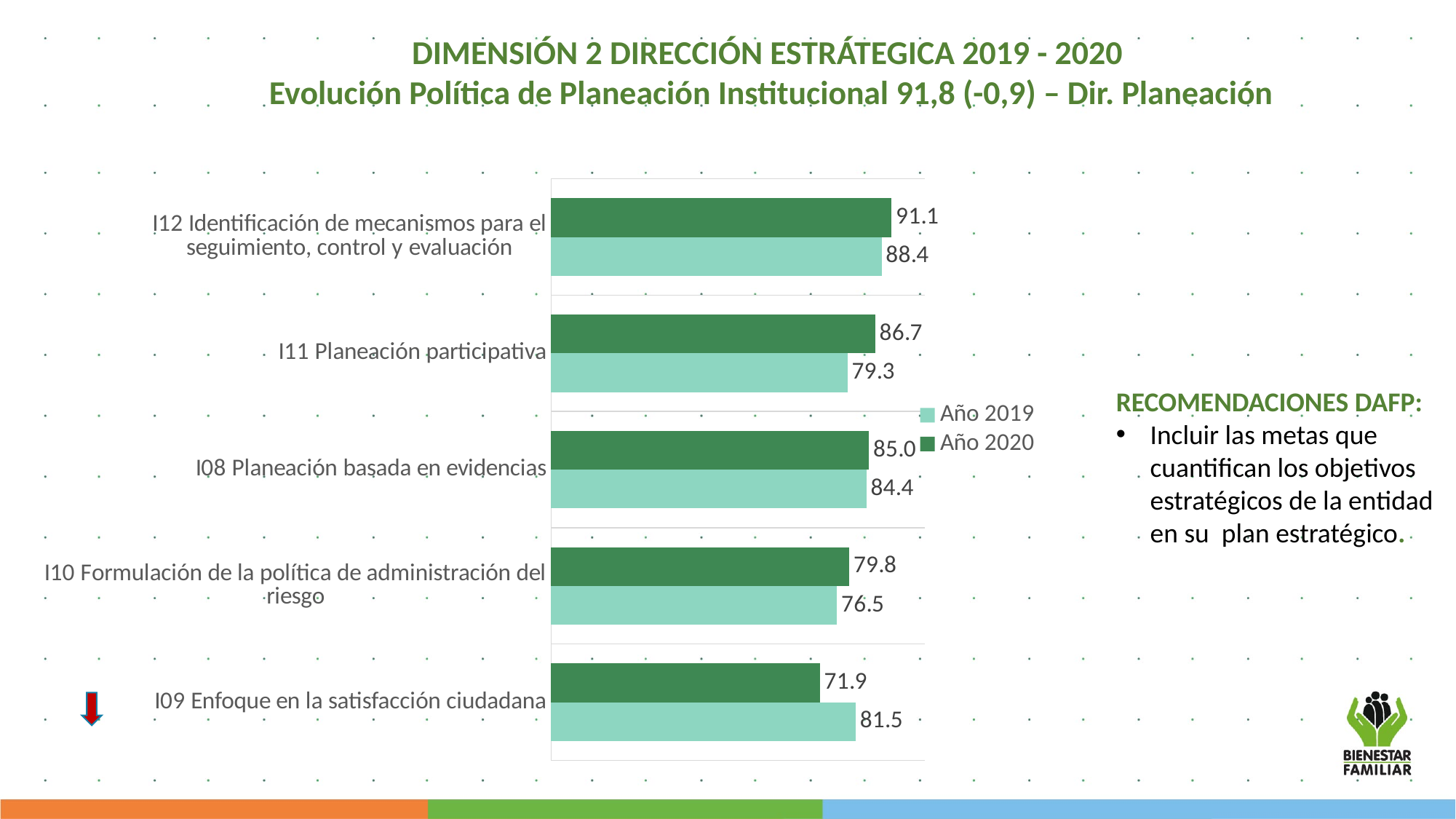
What kind of chart is shown on the slide? Bar chart How many series does the legend list? 2 What is the difference between the Año 2020 and Año 2019 values for I11 Planeación participativa? 7.4 Which category has the lowest Año 2019 value? I10 Formulación de la política de administración del riesgo What is the Año 2020 value for I12 Identificación de mecanismos para el seguimiento, control y evaluación? 91.1 Which category has the highest Año 2020 value? I12 Identificación de mecanismos para el seguimiento, control y evaluación What is the difference between the Año 2019 and Año 2020 values for I09 Enfoque en la satisfacción ciudadana? 9.6 Which category has the lowest Año 2020 value? I09 Enfoque en la satisfacción ciudadana For I10 Formulación de la política de administración del riesgo, which is larger: the Año 2019 value or the Año 2020 value? Año 2020 How many categories are shown in the chart? 5 What is the Año 2019 value for I11 Planeación participativa? 79.3 What is the Año 2019 value for I09 Enfoque en la satisfacción ciudadana? 81.5